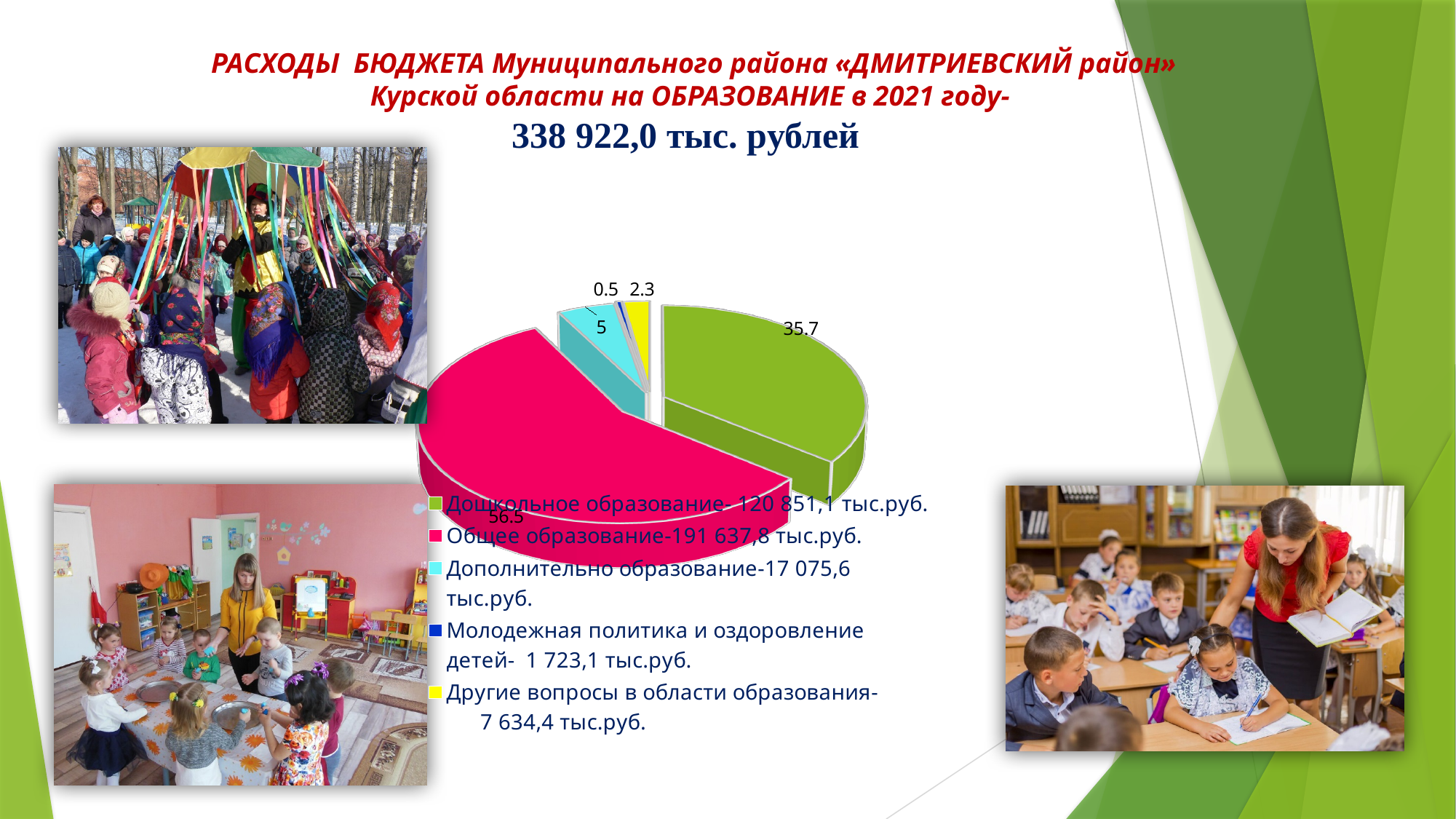
How many slices does the pie chart have? 5 What is the difference between the labelled values for Общее образование and Дошкольное образование? 20.8 What kind of chart is shown on the slide? pie chart What colour is the slice for Дошкольное образование in the pie chart? green What value is labelled on the pie slice for Молодежная политика и оздоровление детей? 0.5 What value is labelled on the pie slice for Другие вопросы в области образования? 2.3 What value is labelled on the pie slice for Общее образование? 56.5 What value is labelled on the pie slice for Дошкольное образование? 35.7 Which slice is larger: Дополнительно образование or Другие вопросы в области образования? Дополнительно образование Which category has the smallest slice of the pie chart? Молодежная политика и оздоровление детей Which category has the largest slice of the pie chart? Общее образование What value is labelled on the pie slice for Дополнительно образование? 5